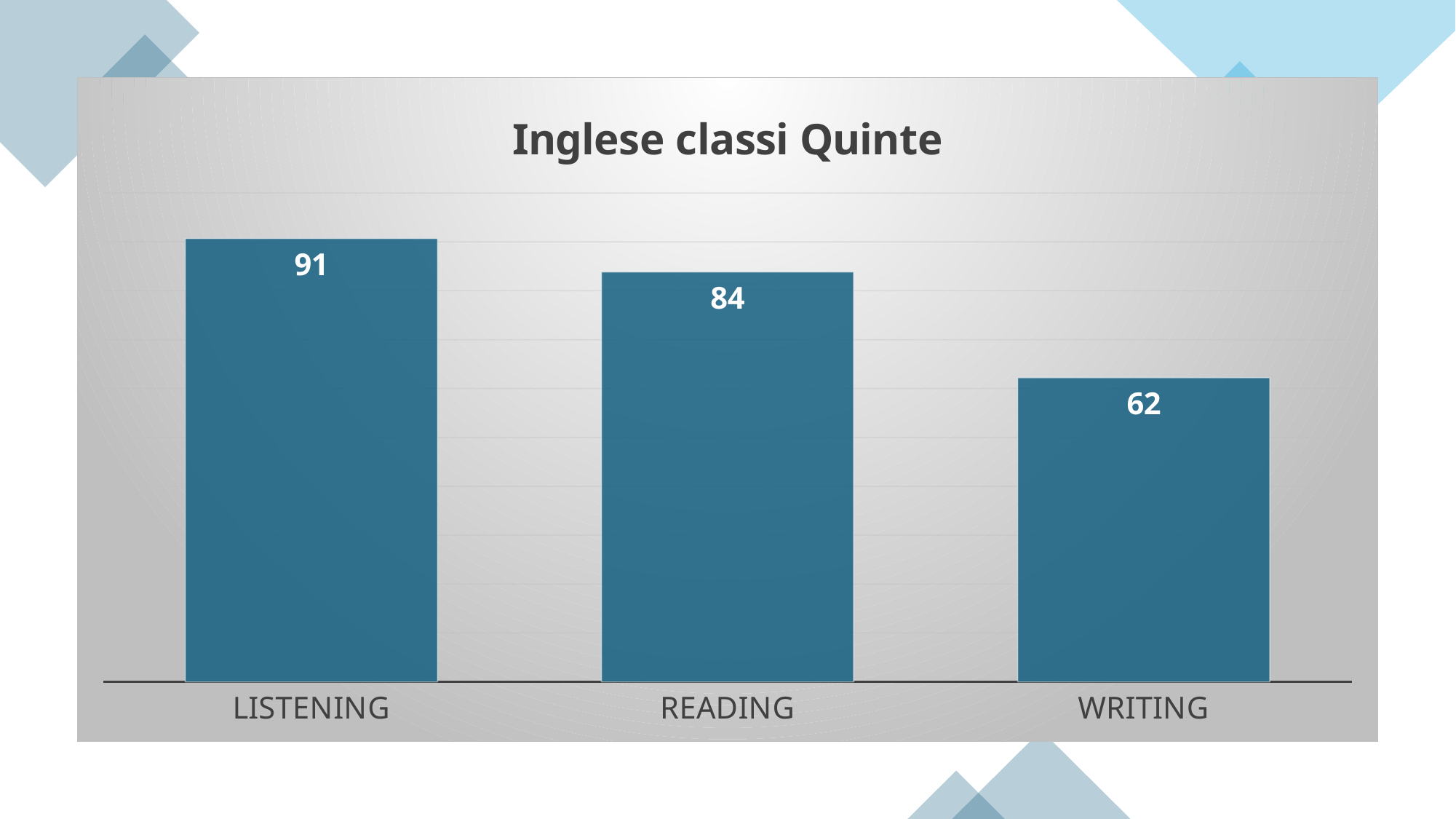
Do the values rise or fall from left to right along the x axis? Fall What is the difference between the values for LISTENING and WRITING? 29 Which is larger, the value for READING or the value for WRITING? READING What is the title of the chart? Inglese classi Quinte Which category has the highest value? LISTENING What is the value for WRITING? 62 What is the value for READING? 84 How many categories are shown on the x axis? 3 What is the difference between the values for LISTENING and READING? 7 Which category has the lowest value? WRITING What kind of chart is shown on the slide? Bar chart What is the value for LISTENING? 91